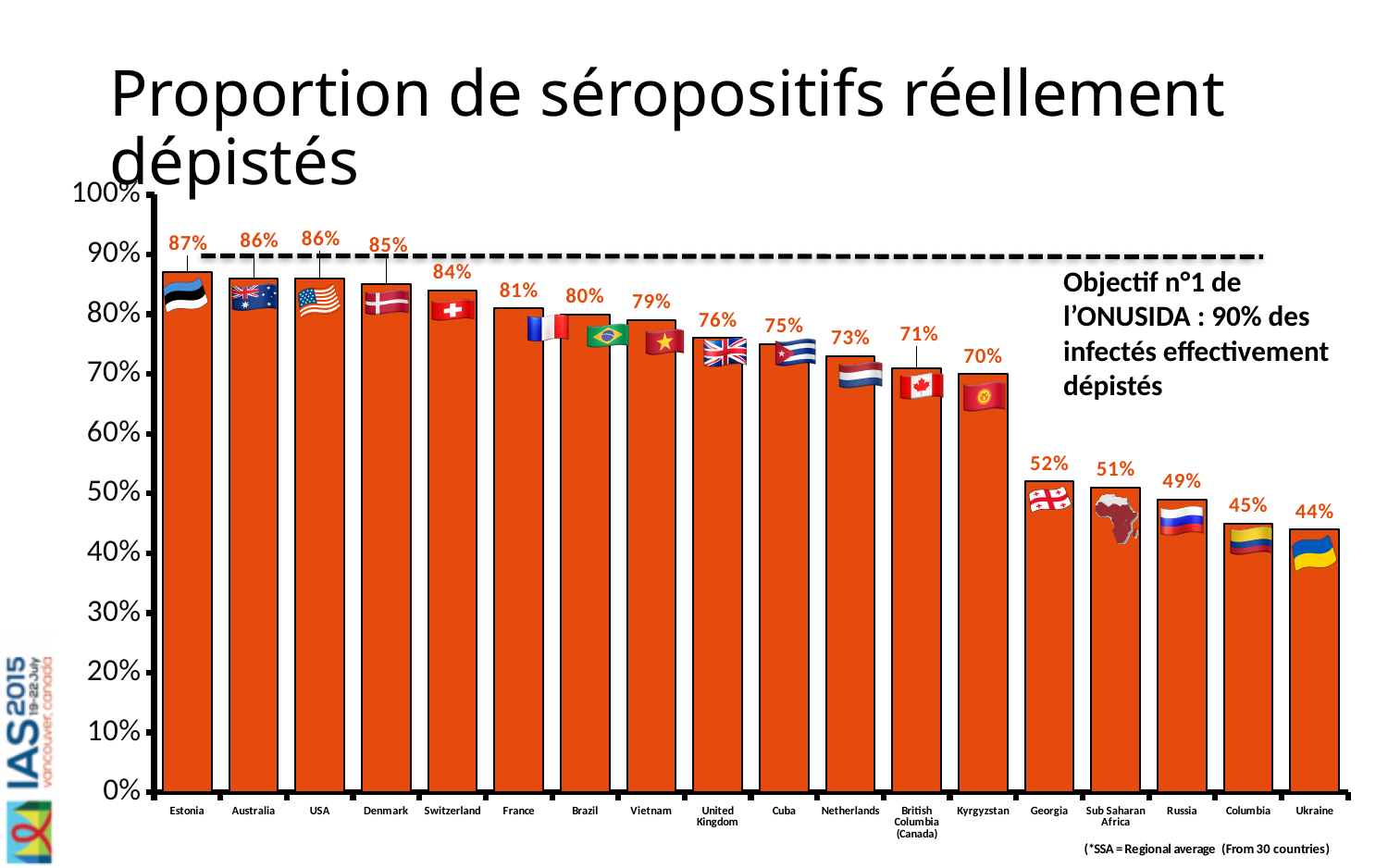
What is the value for France? 81% What kind of chart is shown on the slide? bar chart Which country has the lowest value? Ukraine What target level does the dashed horizontal line on the chart mark? 90% How many countries or regions are shown in the chart? 18 What is the value for Sub Saharan Africa? 51% Is the value for Russia greater or less than 50%? less What is the value for Kyrgyzstan? 70% What is the difference between the values for Kyrgyzstan and Georgia? 18% What is the difference between the values for Estonia and Ukraine? 43% Which country has the highest value? Estonia Which is larger, the value for Cuba or the value for Netherlands? Cuba